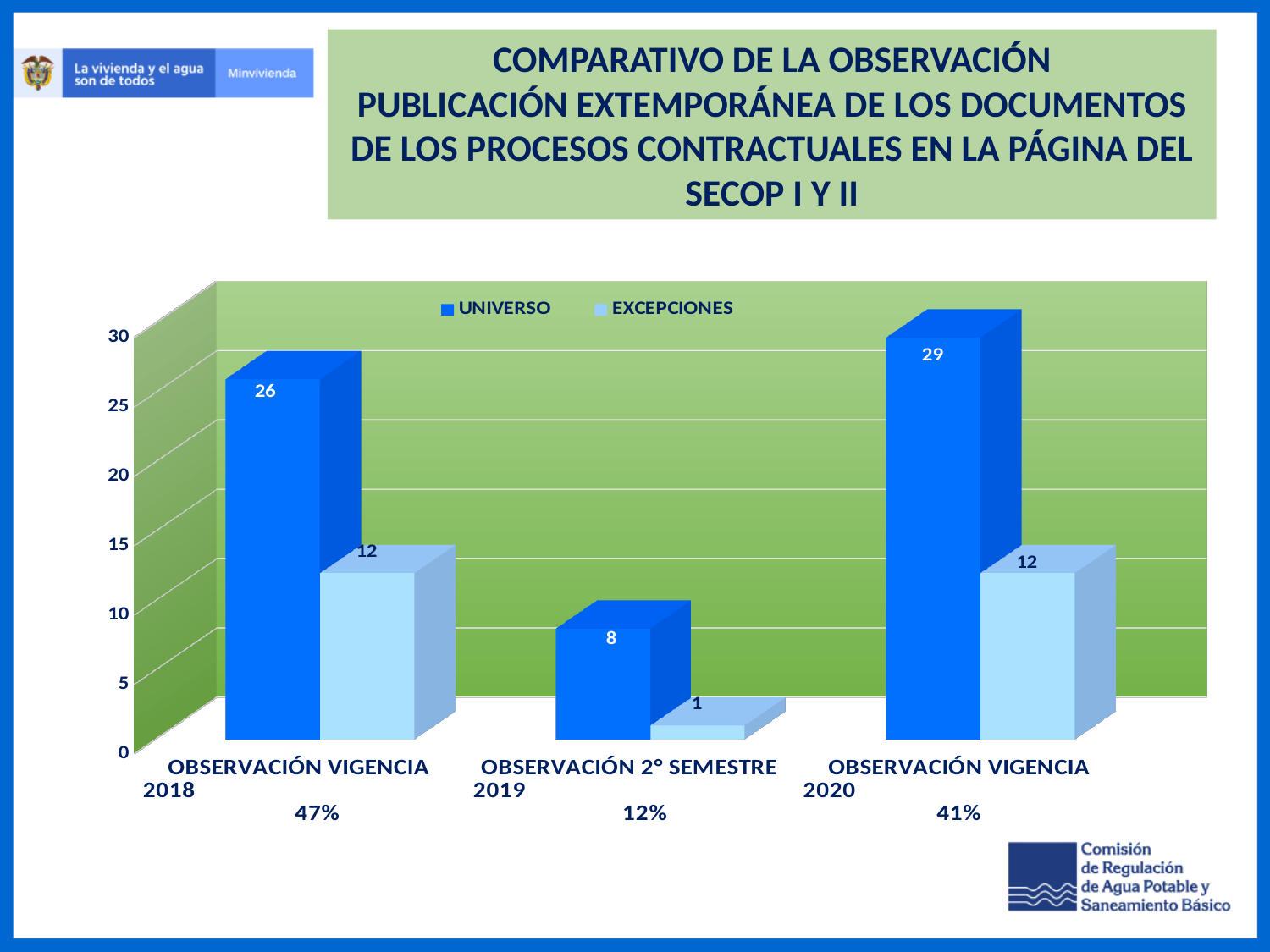
What is the difference between the UNIVERSO values for OBSERVACIÓN VIGENCIA 2020 and OBSERVACIÓN VIGENCIA 2018? 3 How many categories are shown on the x axis? 3 What is the UNIVERSO value for OBSERVACIÓN VIGENCIA 2020? 29 Which is larger, the UNIVERSO value for OBSERVACIÓN 2° SEMESTRE 2019 or the EXCEPCIONES value for OBSERVACIÓN VIGENCIA 2018? EXCEPCIONES value for OBSERVACIÓN VIGENCIA 2018 How many series does the legend list? 2 What is the UNIVERSO value for OBSERVACIÓN VIGENCIA 2018? 26 Which category has the lowest EXCEPCIONES value? OBSERVACIÓN 2° SEMESTRE 2019 What is the difference between the UNIVERSO and EXCEPCIONES values for OBSERVACIÓN VIGENCIA 2018? 14 What kind of chart is shown on the slide? Bar chart Which category has the highest UNIVERSO value? OBSERVACIÓN VIGENCIA 2020 What is the EXCEPCIONES value for OBSERVACIÓN VIGENCIA 2020? 12 What is the EXCEPCIONES value for OBSERVACIÓN 2° SEMESTRE 2019? 1